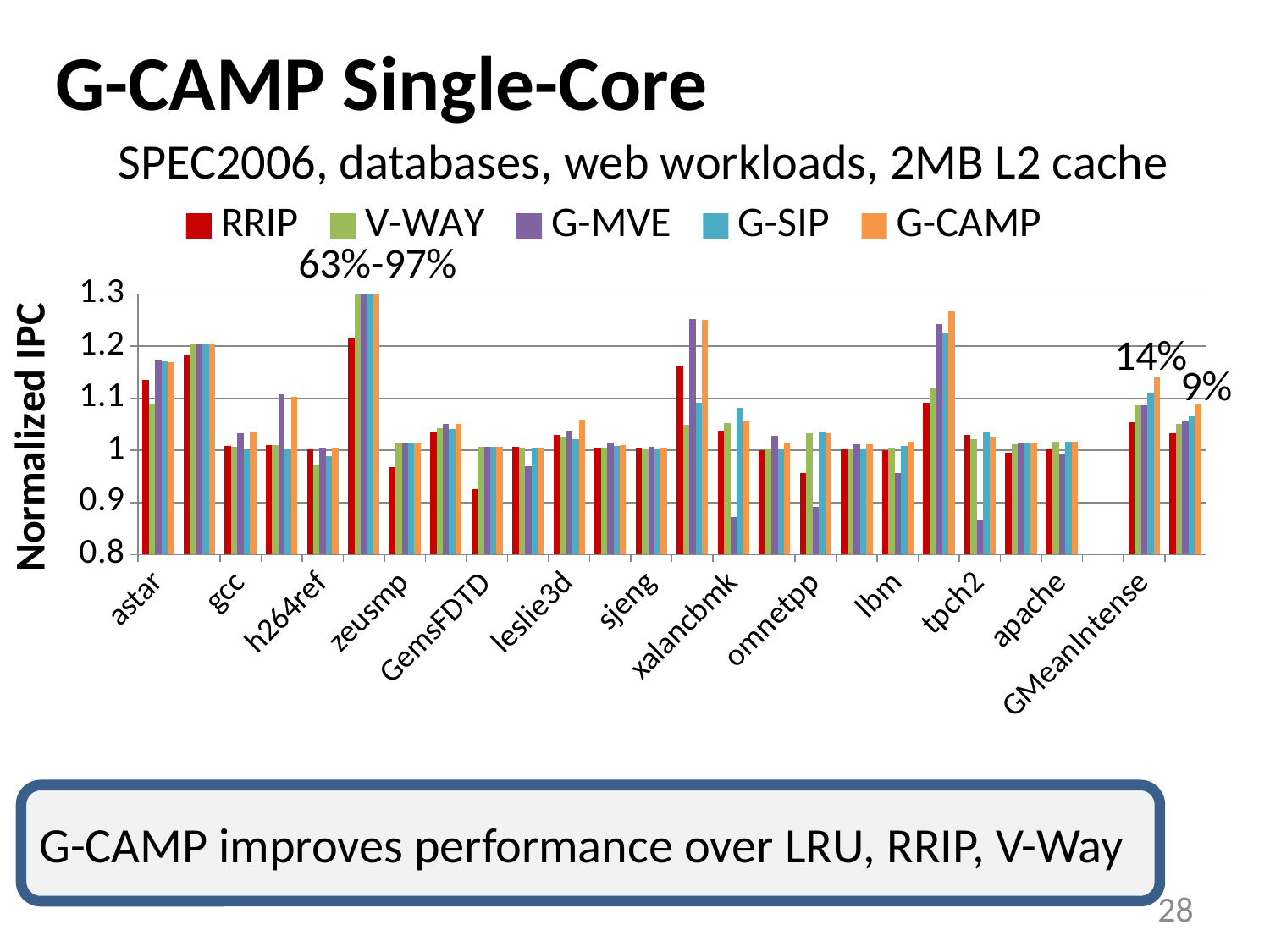
What is the label on the vertical axis of the chart? Normalized IPC How many series does the legend list? 5 Is the G-CAMP value for xalancbmk greater or less than 1.2? less Which series has the lowest value for omnetpp? G-MVE Is the G-MVE value for lbm greater or less than 1? less Is the RRIP value for omnetpp greater or less than 1? less What kind of chart is shown on the slide? bar chart For zeusmp, which is larger: the RRIP value or the G-CAMP value? G-CAMP